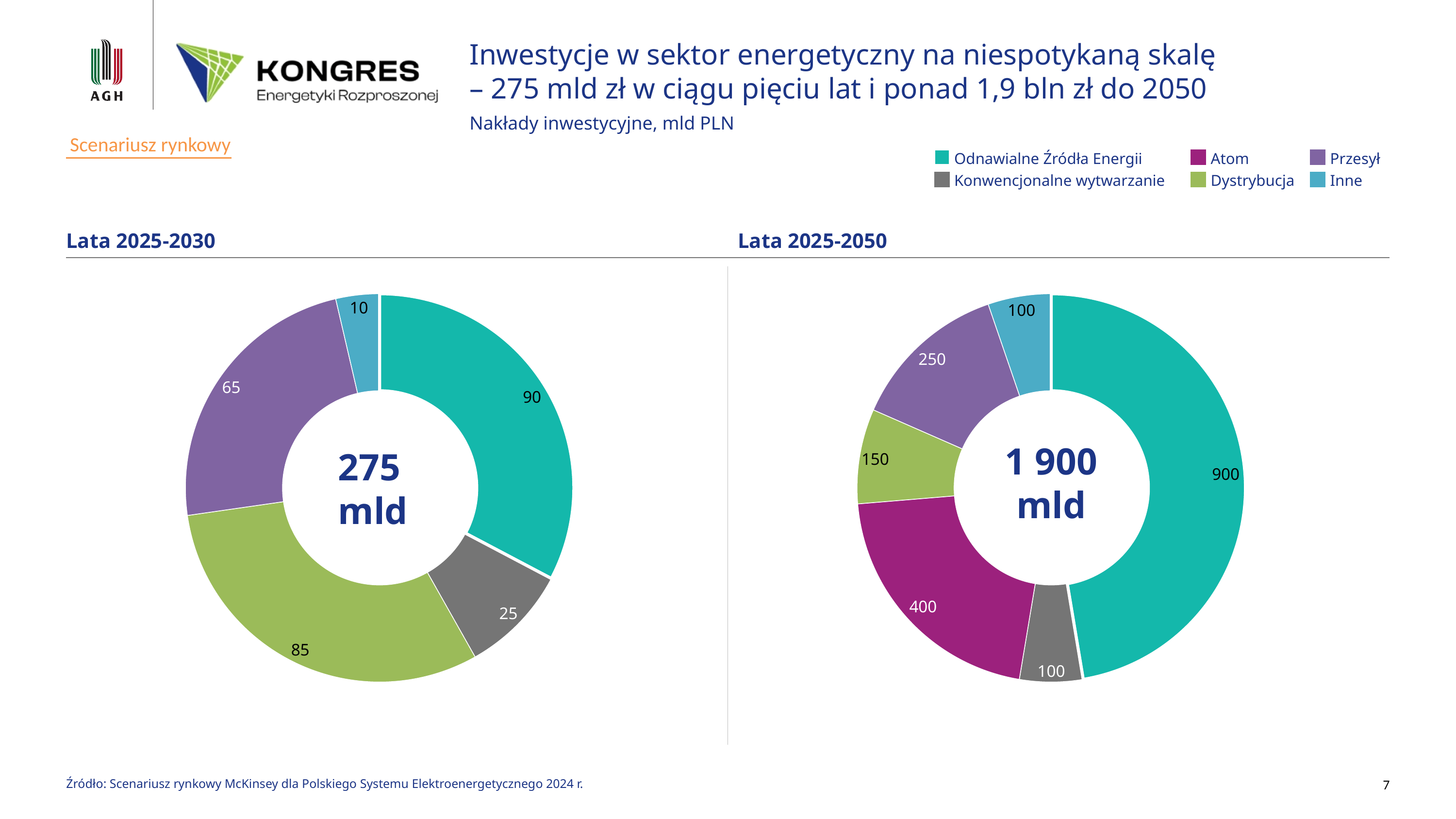
On the 'Lata 2025-2030' chart, which is larger: Dystrybucja or Przesył? Dystrybucja On the 'Lata 2025-2050' chart, what is the value for Dystrybucja? 150 On the 'Lata 2025-2050' chart, what is the value for Atom? 400 What is the total shown in the centre of the 'Lata 2025-2050' chart? 1 900 mld On the 'Lata 2025-2030' chart, what is the difference between Odnawialne Źródła Energii and Konwencjonalne wytwarzanie? 65 What kind of chart is used on the slide? Pie (donut) chart On the 'Lata 2025-2050' chart, what is the difference between Atom and Przesył? 150 On the 'Lata 2025-2030' chart, which category has the lowest value? Inne On the 'Lata 2025-2050' chart, which category has the highest value? Odnawialne Źródła Energii On the 'Lata 2025-2030' chart, what is the value for Odnawialne Źródła Energii? 90 How many slices does the 'Lata 2025-2050' chart have? 6 On the 'Lata 2025-2030' chart, what is the value for Przesył? 65